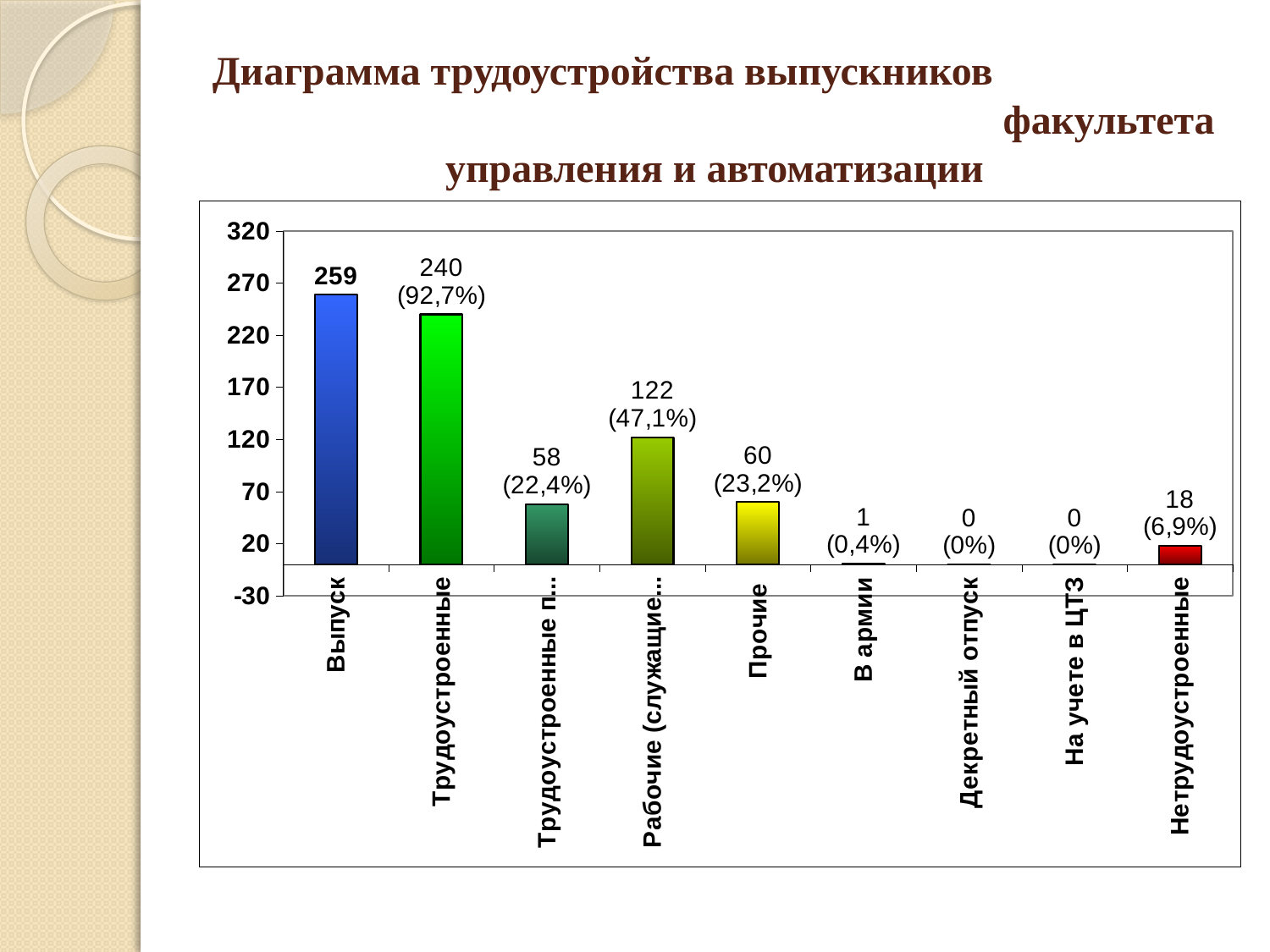
What is the value for Выпуск? 259 What percentage is shown for Трудоустроенные? 92,7% What percentage is shown for Нетрудоустроенные? 6,9% What is the value for Трудоустроенные? 240 What is the value for В армии? 1 What is the difference between the values for Выпуск and Трудоустроенные? 19 Which category has the highest value? Выпуск What is the value for Нетрудоустроенные? 18 How many categories are shown on the x axis? 9 Which is larger, the value for Прочие or the value for Нетрудоустроенные? Прочие What type of chart is shown on the slide? bar chart Is the value for Трудоустроенные greater or less than 220? greater